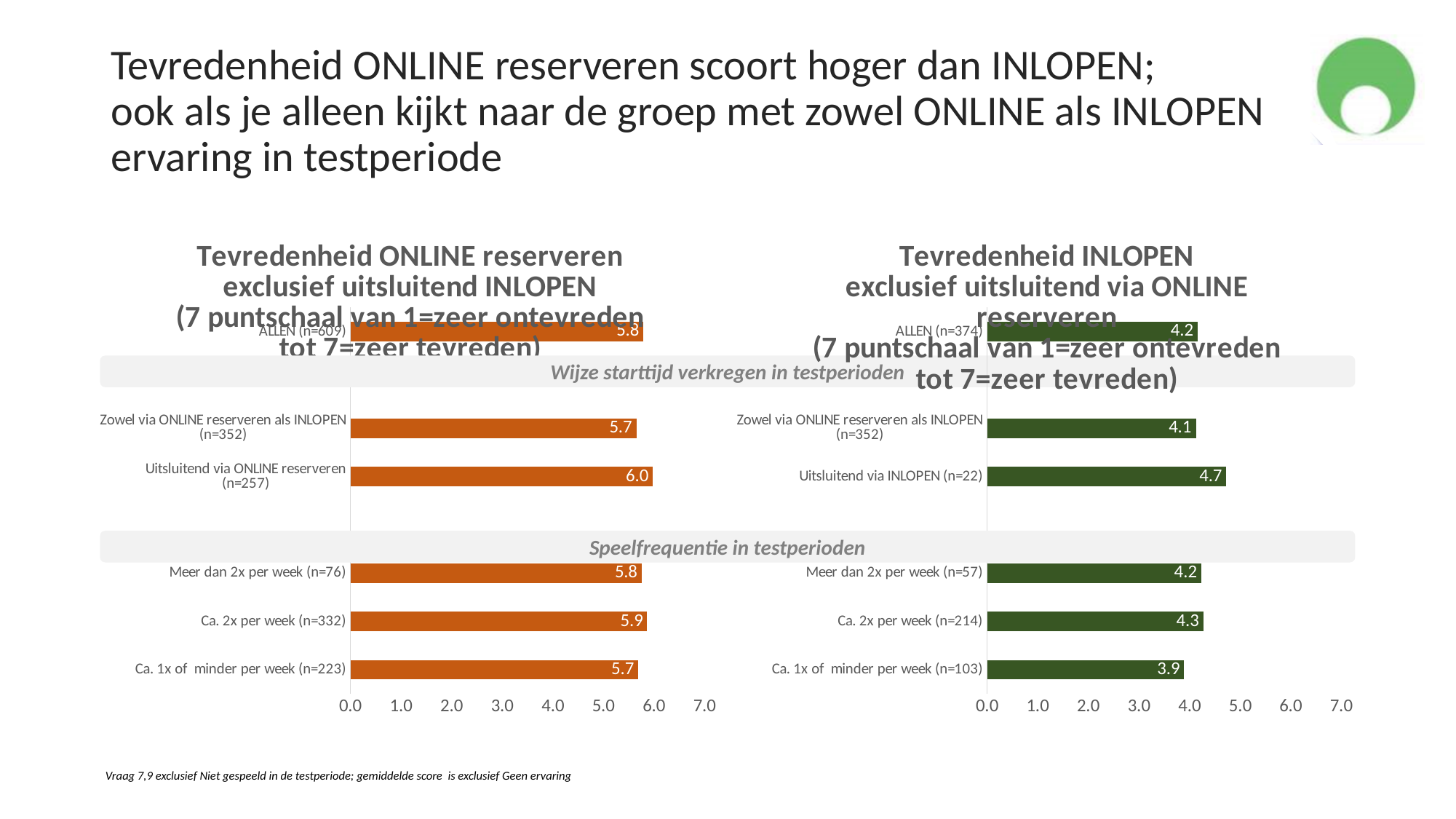
Which is larger: the value for Zowel via ONLINE reserveren als INLOPEN (n=352) in the left chart or in the right chart? The left chart (5.7) In the right chart (Tevredenheid INLOPEN), which category has the lowest value? Ca. 1x of minder per week (n=103) In the left chart (Tevredenheid ONLINE reserveren), what is the value for ALLEN (n=609)? 5.8 In the right chart (Tevredenheid INLOPEN), what is the difference between Uitsluitend via INLOPEN (n=22) and Zowel via ONLINE reserveren als INLOPEN (n=352)? 0.6 In the right chart (Tevredenheid INLOPEN), what is the value for Uitsluitend via INLOPEN (n=22)? 4.7 What is the maximum value shown on the x axis of the right chart (Tevredenheid INLOPEN)? 7.0 In the left chart (Tevredenheid ONLINE reserveren), which category has the highest value? Uitsluitend via ONLINE reserveren (n=257) In the right chart (Tevredenheid INLOPEN), what is the value for Ca. 1x of minder per week (n=103)? 3.9 In the left chart (Tevredenheid ONLINE reserveren), what is the difference between Uitsluitend via ONLINE reserveren (n=257) and Ca. 1x of minder per week (n=223)? 0.3 How many bars does the right chart (Tevredenheid INLOPEN) show? 6 What kind of chart is the left chart (Tevredenheid ONLINE reserveren)? Bar chart In the left chart (Tevredenheid ONLINE reserveren), what is the value for Ca. 2x per week (n=332)? 5.9